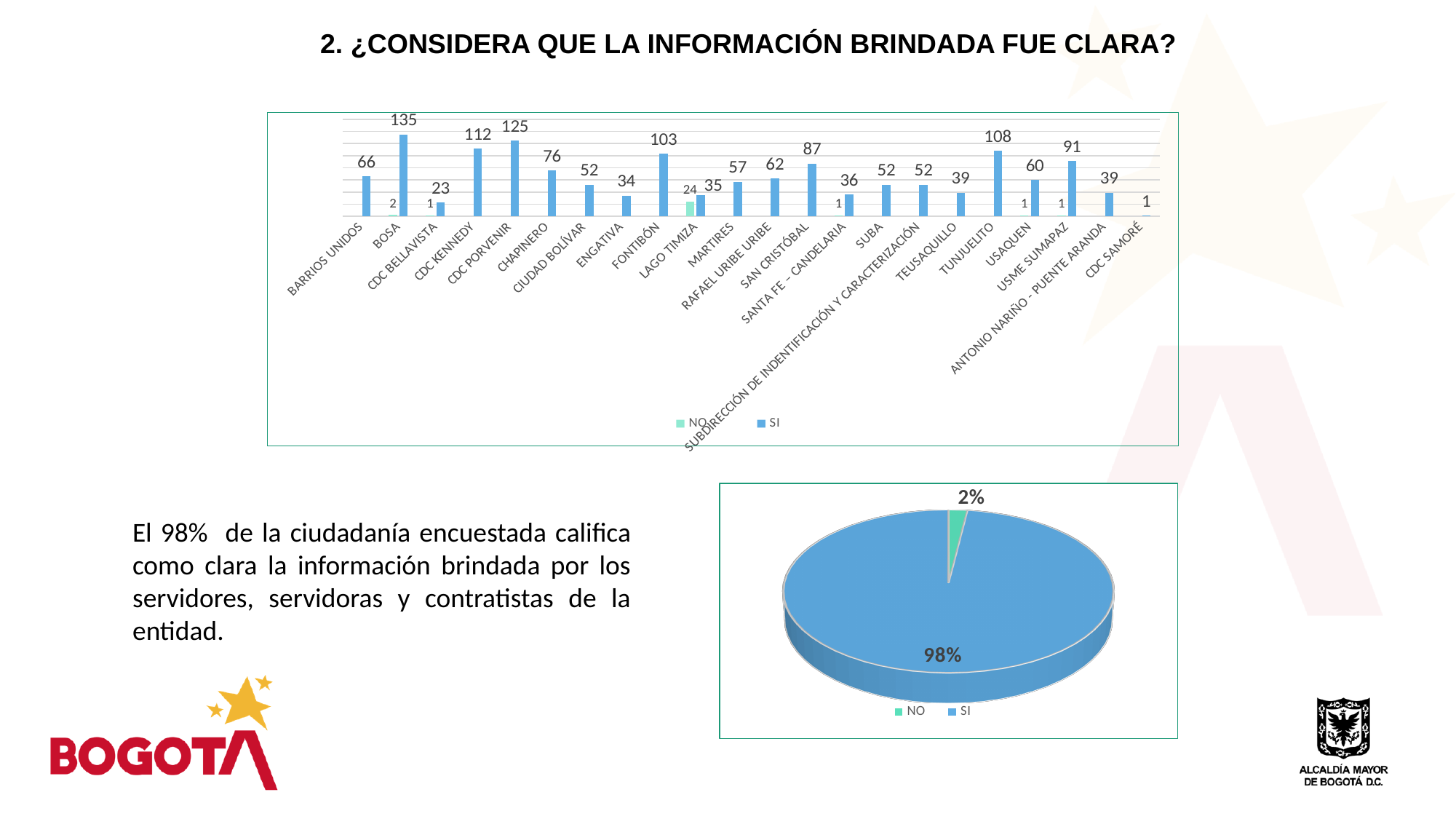
In the pie chart at the bottom right of the slide, what share does the SI slice have? 98% In the bar chart at the top of the slide, what is the NO value for LAGO TIMIZA? 24 In the pie chart at the bottom right of the slide, what share does the NO slice have? 2% How many series does the legend of the bar chart at the top of the slide list? 2 How many categories are shown on the x axis of the bar chart at the top of the slide? 22 In the bar chart at the top of the slide, which category has the lowest SI value? CDC SAMORÉ In the bar chart at the top of the slide, which has a larger SI value, TUNJUELITO or USME SUMAPAZ? TUNJUELITO In the bar chart at the top of the slide, which category has the highest SI value? BOSA In the bar chart at the top of the slide, what is the difference between the SI values for CDC PORVENIR and CDC KENNEDY? 13 In the bar chart at the top of the slide, what is the SI value for BOSA? 135 What kind of chart is shown at the bottom right of the slide? Pie chart In the bar chart at the top of the slide, what is the SI value for FONTIBÓN? 103